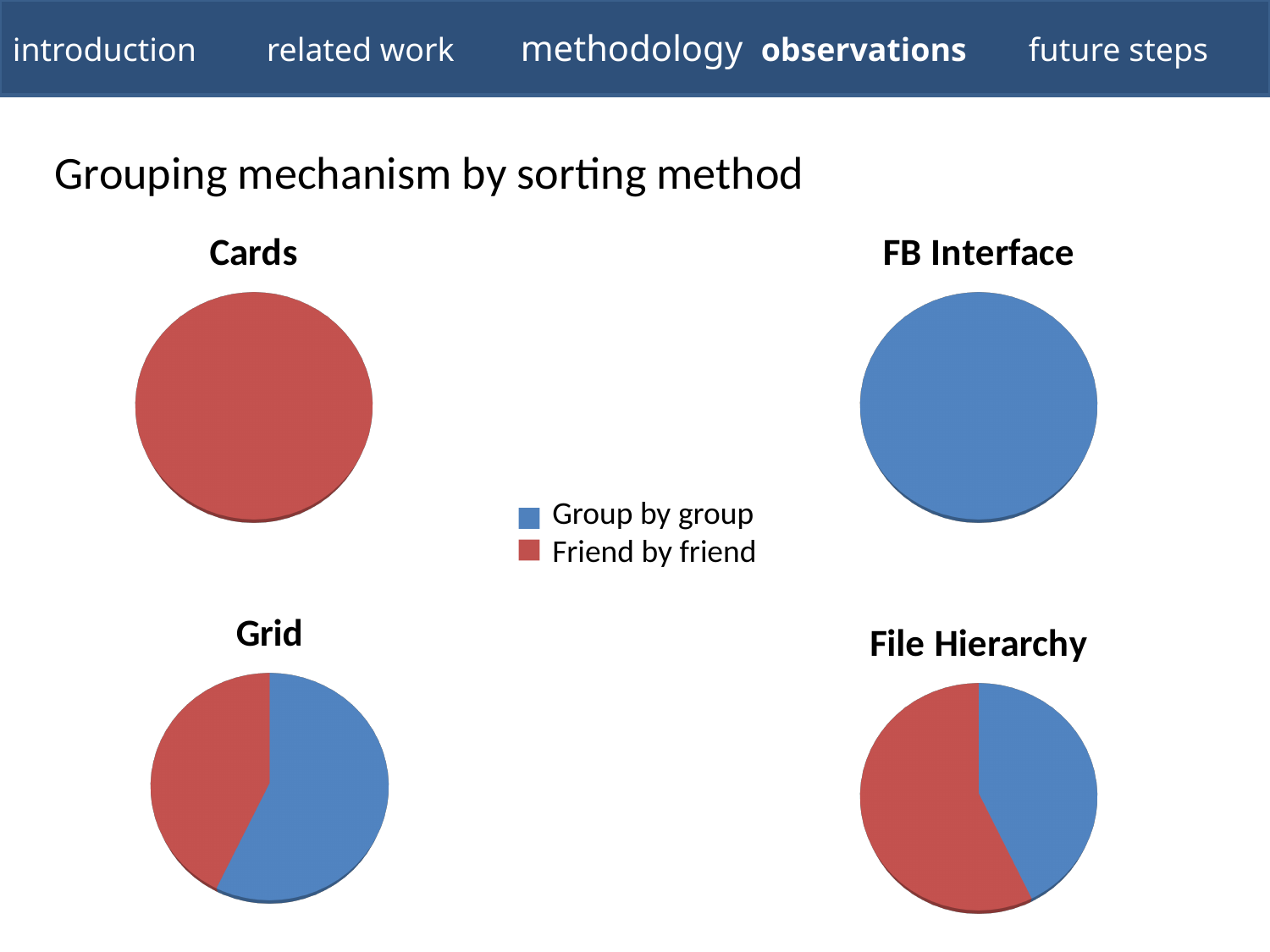
In the File Hierarchy chart, which category has the smaller slice? Group by group In the Grid chart, which category has the larger slice? Group by group What kind of chart is the Cards chart? pie chart What is the title of the File Hierarchy chart's neighbouring chart in the top-right of the slide? FB Interface In the Grid chart, is the Group by group slice larger or smaller than the Friend by friend slice? larger In the Cards chart, which category makes up the entire pie? Friend by friend What colour represents Group by group in the legend? blue In the File Hierarchy chart, which category has the larger slice? Friend by friend In the Grid chart, which category has the smaller slice? Friend by friend In the File Hierarchy chart, is the Group by group slice larger or smaller than the Friend by friend slice? smaller How many entries does the legend list for the pie charts? 2